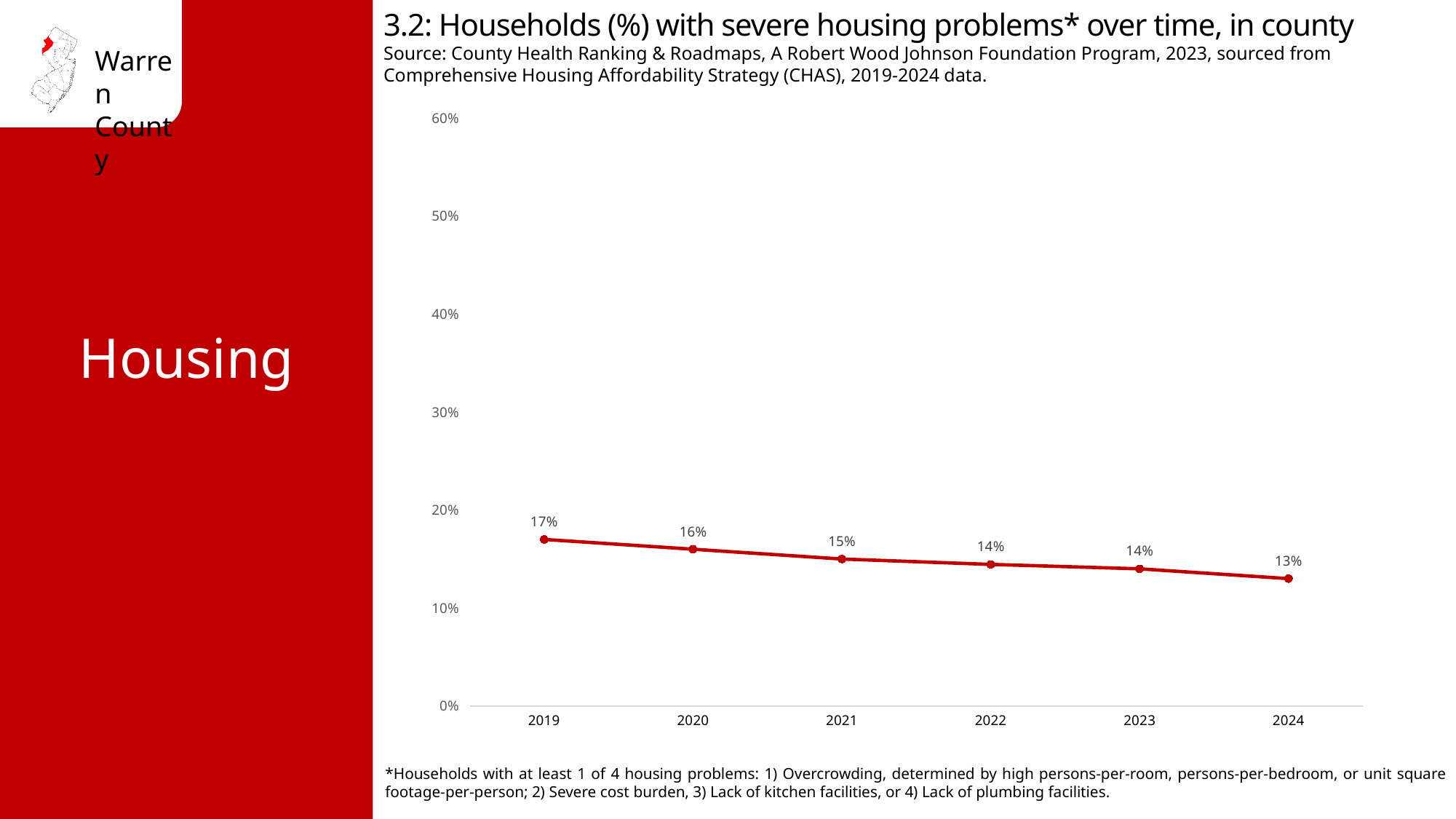
What is the value plotted for 2021? 15% What kind of chart is shown on the slide? line chart What is the difference in percentage points between 2019 and 2024? 4 Is the value for 2022 greater or less than 20%? less Which year has a higher value, 2020 or 2023? 2020 How many years are plotted on the chart? 6 What percentage of households had severe housing problems in 2019? 17% What percentage of households had severe housing problems in 2024? 13% Do the values rise or fall from 2019 to 2024? fall What is the highest value shown on the vertical axis? 60% Which year has the lowest percentage of households with severe housing problems? 2024 Which year has the highest percentage of households with severe housing problems? 2019